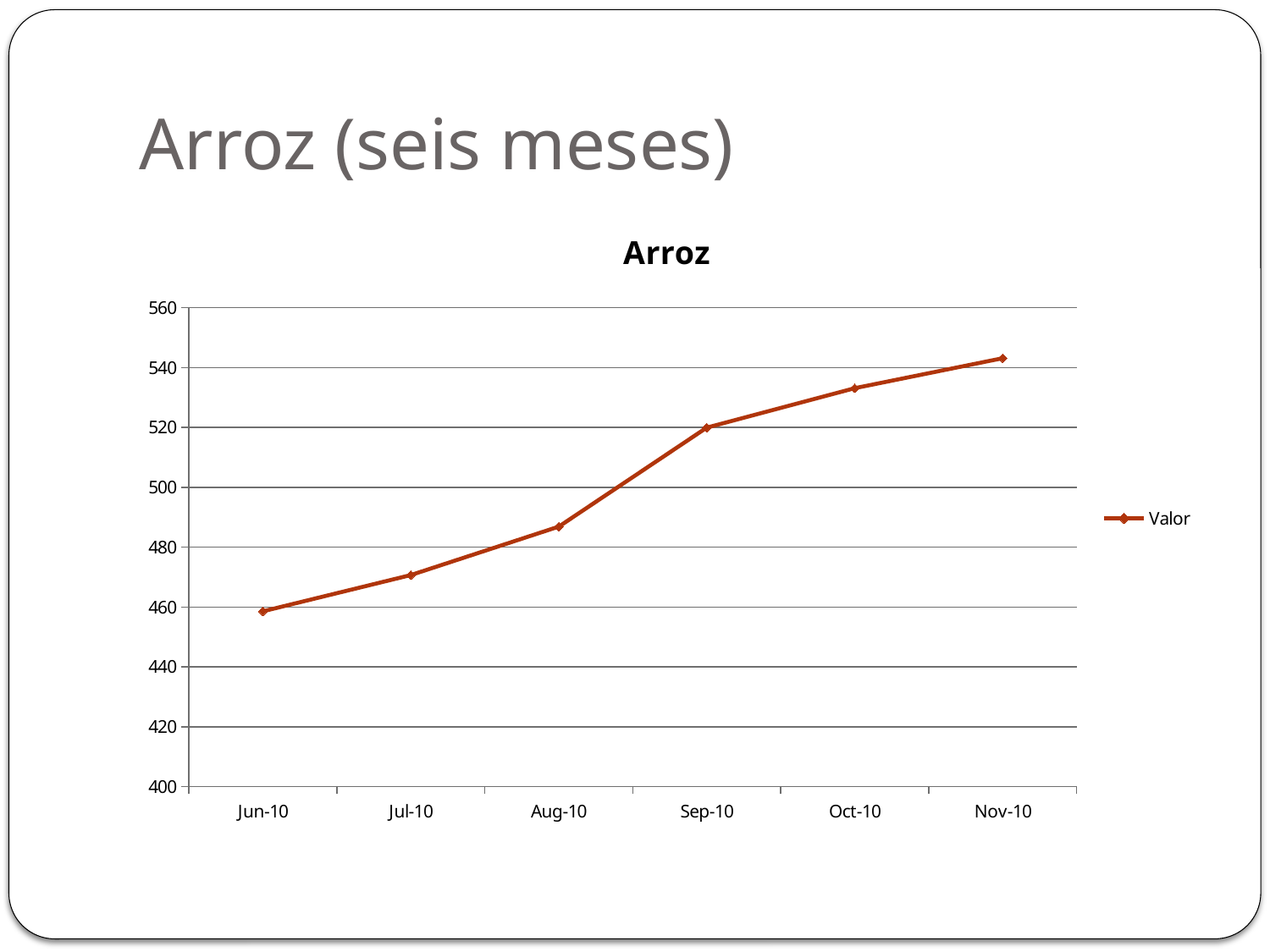
How many data points are plotted on the Arroz chart? 6 Is the value for Aug-10 greater or less than 500? less Is the value for Oct-10 greater or less than 520? greater Which month has the highest value on the Arroz chart? Nov-10 Is the value for Jul-10 greater or less than 460? greater What is the name of the series shown in the legend? Valor What is the title of the chart? Arroz Which month has the lowest value on the Arroz chart? Jun-10 How many series does the legend of the Arroz chart list? 1 Do the values rise or fall from Jun-10 to Nov-10? rise Which is larger, the value for Oct-10 or the value for Jul-10? Oct-10 What kind of chart is shown on the slide? line chart